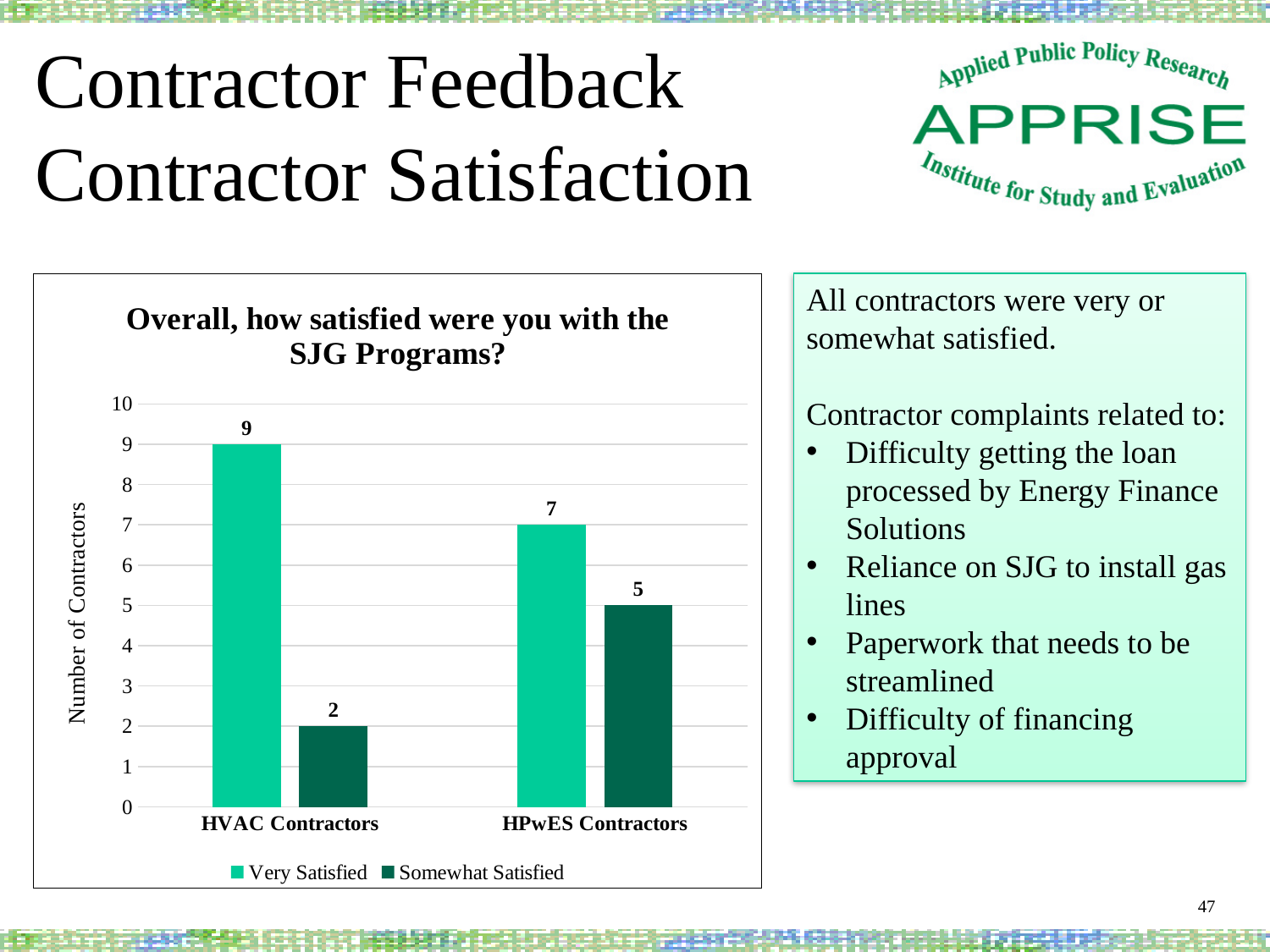
What is the title of the chart? Overall, how satisfied were you with the SJG Programs? How many HPwES Contractors were Somewhat Satisfied? 5 Which is larger: the Somewhat Satisfied value for HPwES Contractors or for HVAC Contractors? HPwES Contractors Which category has the lowest Somewhat Satisfied value? HVAC Contractors How many contractor categories are shown on the x axis? 2 What is the difference between the Very Satisfied and Somewhat Satisfied values for HVAC Contractors? 7 Which category has the highest Very Satisfied value? HVAC Contractors How many series does the legend list? 2 How many HPwES Contractors were Very Satisfied? 7 How many HVAC Contractors were Very Satisfied? 9 How many HVAC Contractors were Somewhat Satisfied? 2 What kind of chart is shown on the slide? Bar chart